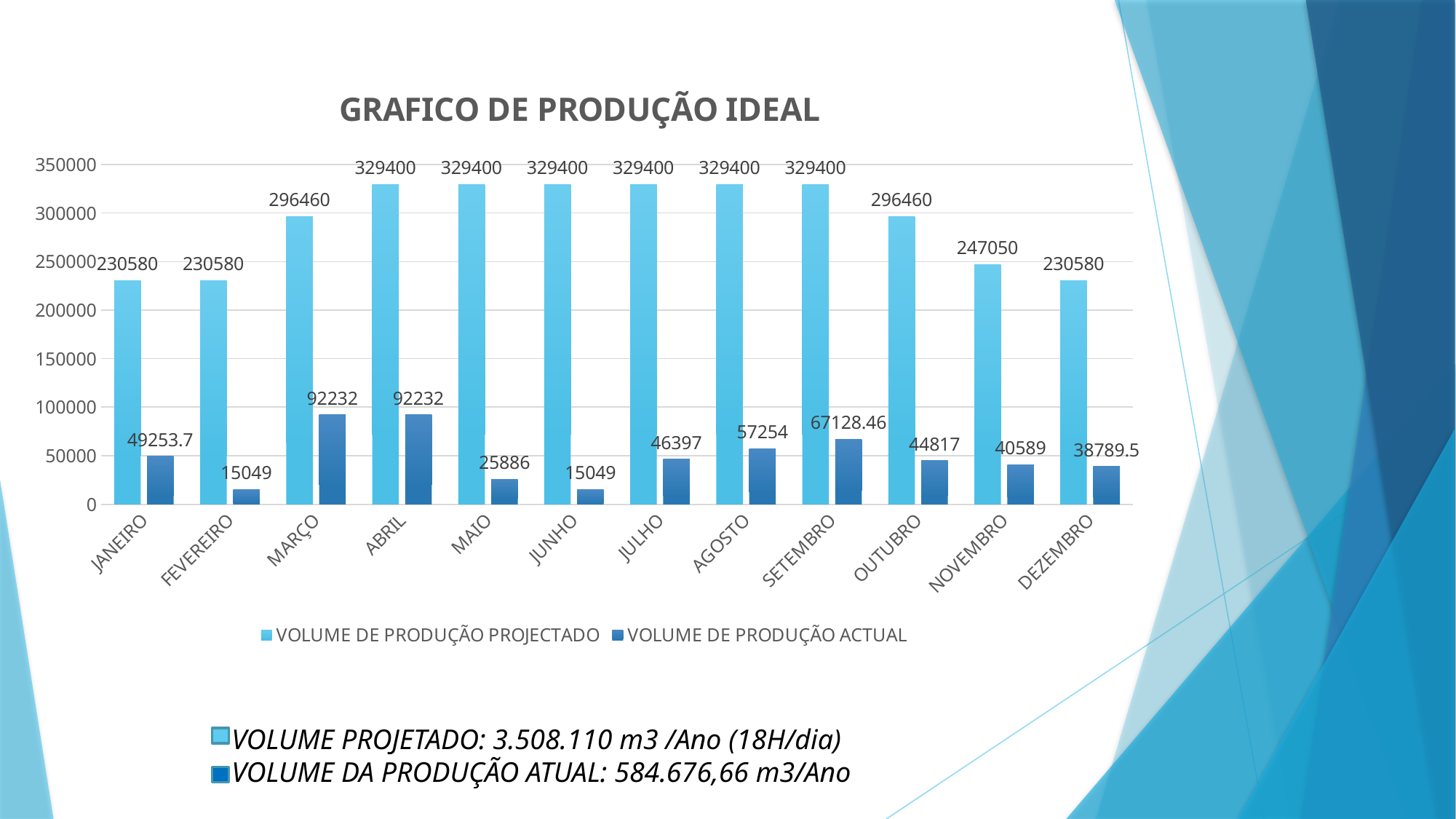
How many series does the chart legend list? 2 What is the VOLUME DE PRODUÇÃO PROJECTADO value for MARÇO? 296460 What is the VOLUME DE PRODUÇÃO ACTUAL value for SETEMBRO? 67128.46 What is the VOLUME DE PRODUÇÃO ACTUAL value for JANEIRO? 49253.7 What is the difference between the VOLUME DE PRODUÇÃO ACTUAL values for AGOSTO and JULHO? 10857 How many months are shown on the x axis of the chart? 12 What is the difference between the VOLUME DE PRODUÇÃO PROJECTADO and VOLUME DE PRODUÇÃO ACTUAL values for SETEMBRO? 262271.54 Is the VOLUME DE PRODUÇÃO ACTUAL value for OUTUBRO greater or less than 50000? less Which month has the larger VOLUME DE PRODUÇÃO ACTUAL value, MAIO or JULHO? JULHO What kind of chart is shown on the slide? bar chart What is the VOLUME DE PRODUÇÃO PROJECTADO value for NOVEMBRO? 247050 What is the title of the chart? GRAFICO DE PRODUÇÃO IDEAL